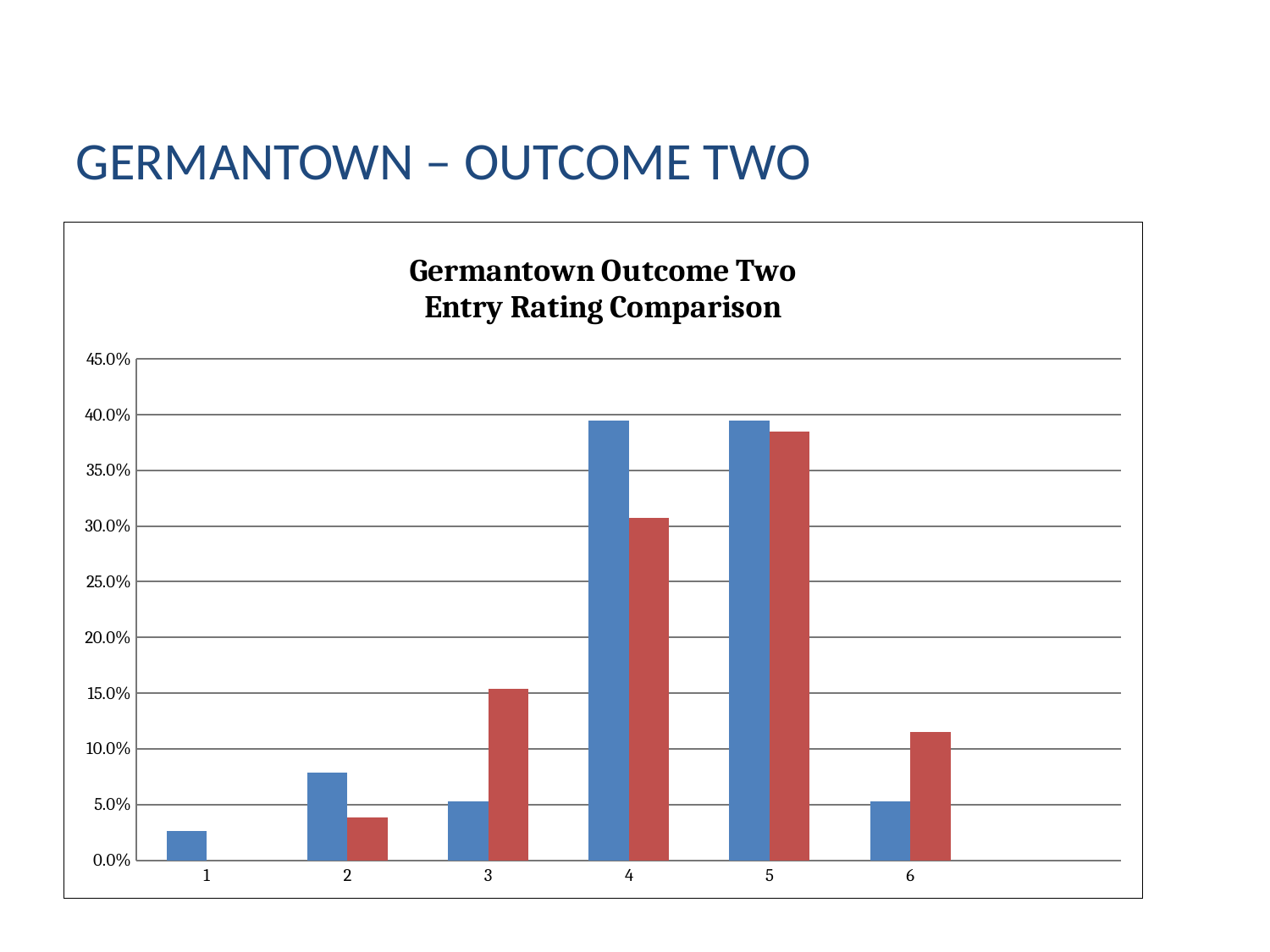
What is the title of the chart? Germantown Outcome Two Entry Rating Comparison Is the value of the blue bar for category 4 greater or less than 35.0%? greater At category 3, which bar is larger, the blue bar or the red bar? red What kind of chart is shown on the slide? bar chart Is the value of the blue bar for category 1 greater or less than 5.0%? less For which category is the blue bar the lowest? 1 How many differently coloured bar series are plotted in the chart? 2 Is the value of the red bar for category 3 greater or less than 10.0%? greater At category 4, which bar is larger, the blue bar or the red bar? blue At category 6, which bar is larger, the blue bar or the red bar? red For which category is the red bar the highest? 5 How many categories are shown on the x axis? 6